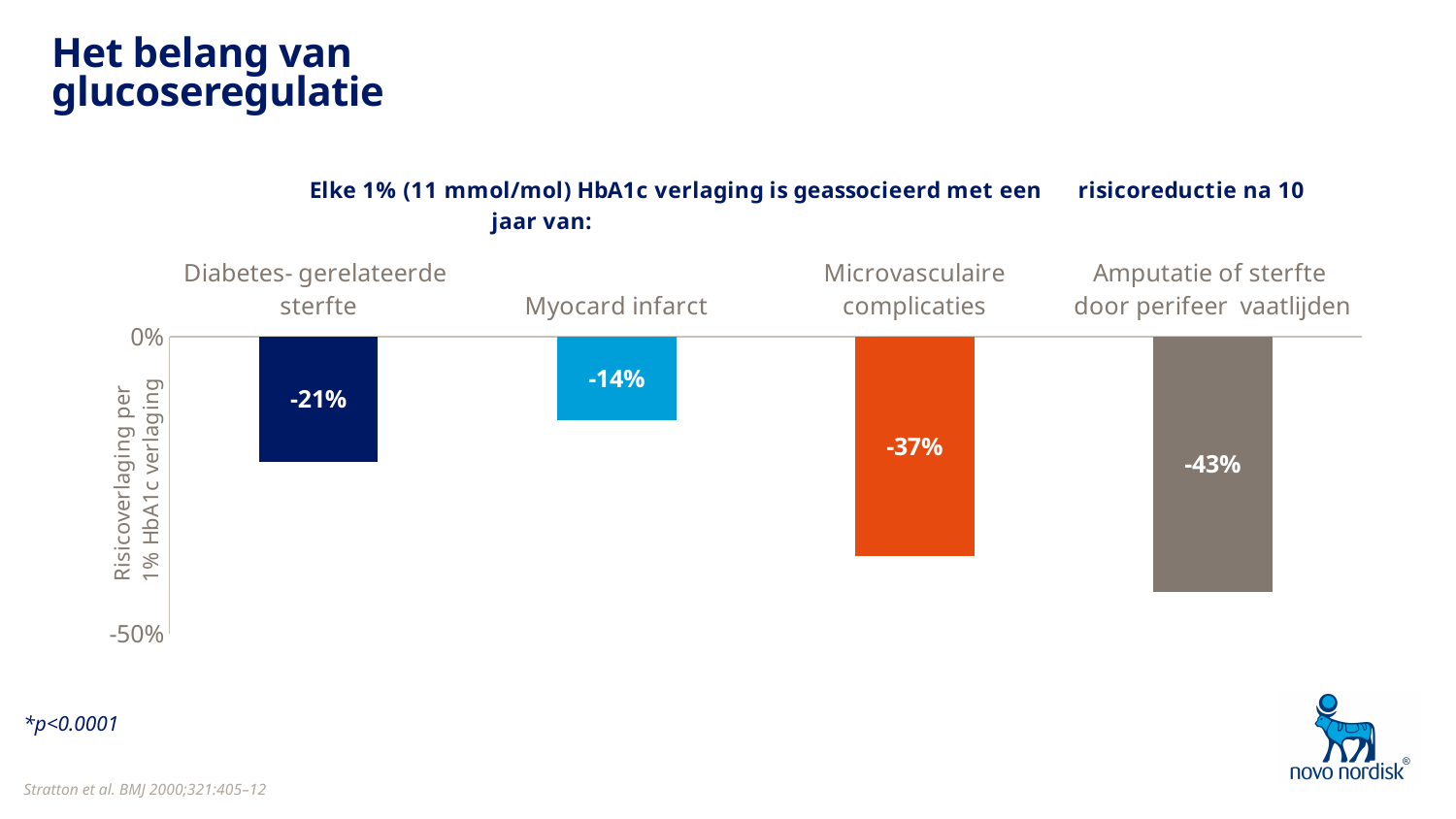
What is the value shown for Diabetes-gerelateerde sterfte? -21% What is the lowest value shown on the vertical axis? -50% What kind of chart is shown on the slide? Bar chart Which category shows the smallest risk reduction (the value closest to 0%)? Myocard infarct What is the difference in percentage points between the values for Microvasculaire complicaties and Myocard infarct? 23 percentage points What is the value shown for Myocard infarct? -14% Which category shows the largest risk reduction (the most negative value)? Amputatie of sterfte door perifeer vaatlijden What is the value shown for Microvasculaire complicaties? -37% What is the value shown for Amputatie of sterfte door perifeer vaatlijden? -43% How many categories are shown in the chart? 4 What is the label of the vertical axis? Risicoverlaging per 1% HbA1c verlaging Which has a larger risk reduction: Diabetes-gerelateerde sterfte or Microvasculaire complicaties? Microvasculaire complicaties